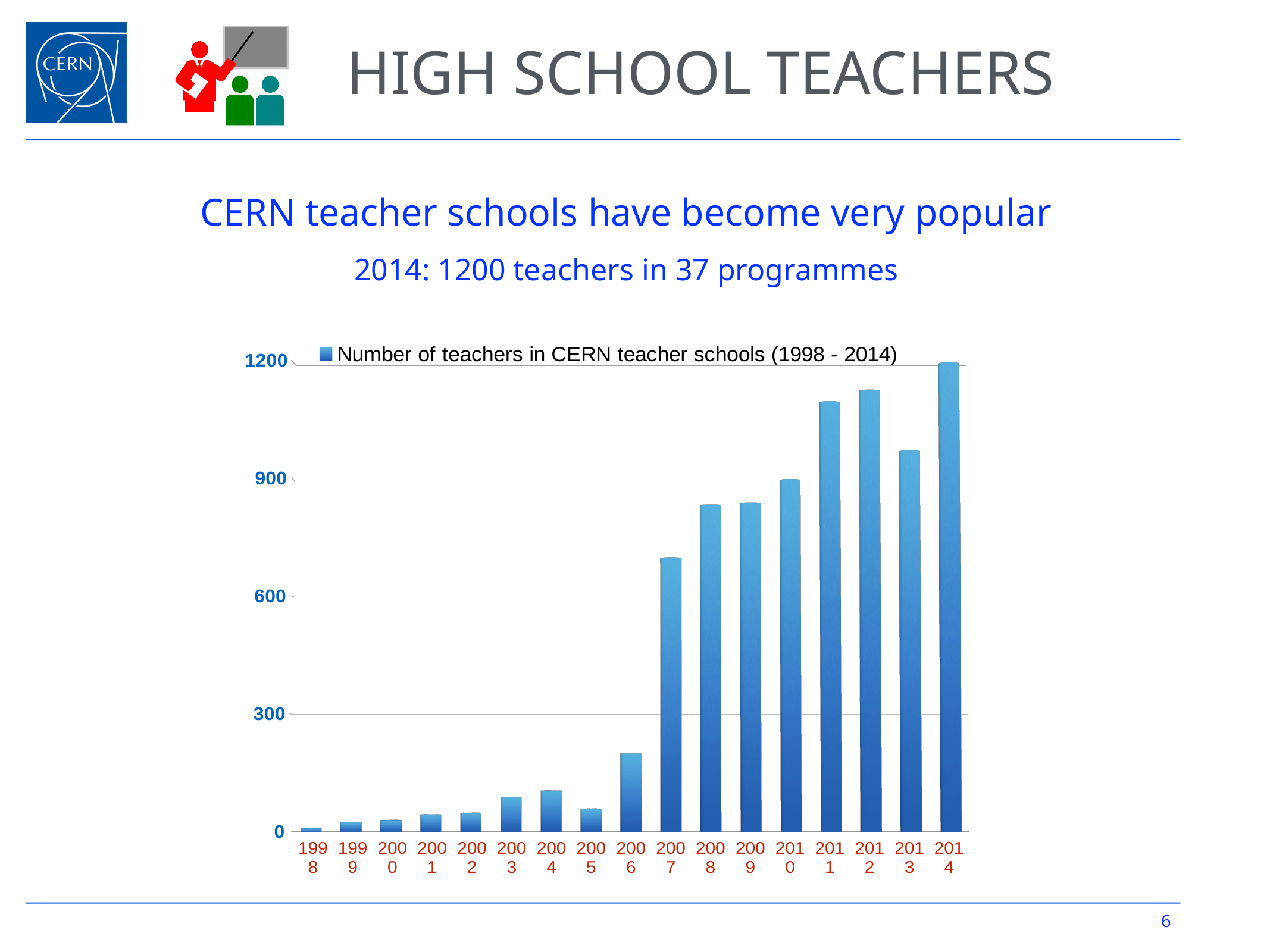
What is the legend entry of the series shown in the chart? Number of teachers in CERN teacher schools (1998 - 2014) How many series does the chart legend list? 1 Which year has the highest number of teachers in CERN teacher schools? 2014 Is the value for 2007 greater or less than 600? greater How many years (bars) are plotted in the chart? 17 Overall, do the values rise or fall from 1998 to 2014? rise Which year has the larger value, 2012 or 2013? 2012 What kind of chart is shown on the slide? bar chart Is the value for 2008 greater or less than 900? less What is the number of teachers in CERN teacher schools in 2014? 1200 Which year has the lowest number of teachers in CERN teacher schools? 1998 Is the value for 2006 greater or less than 300? less